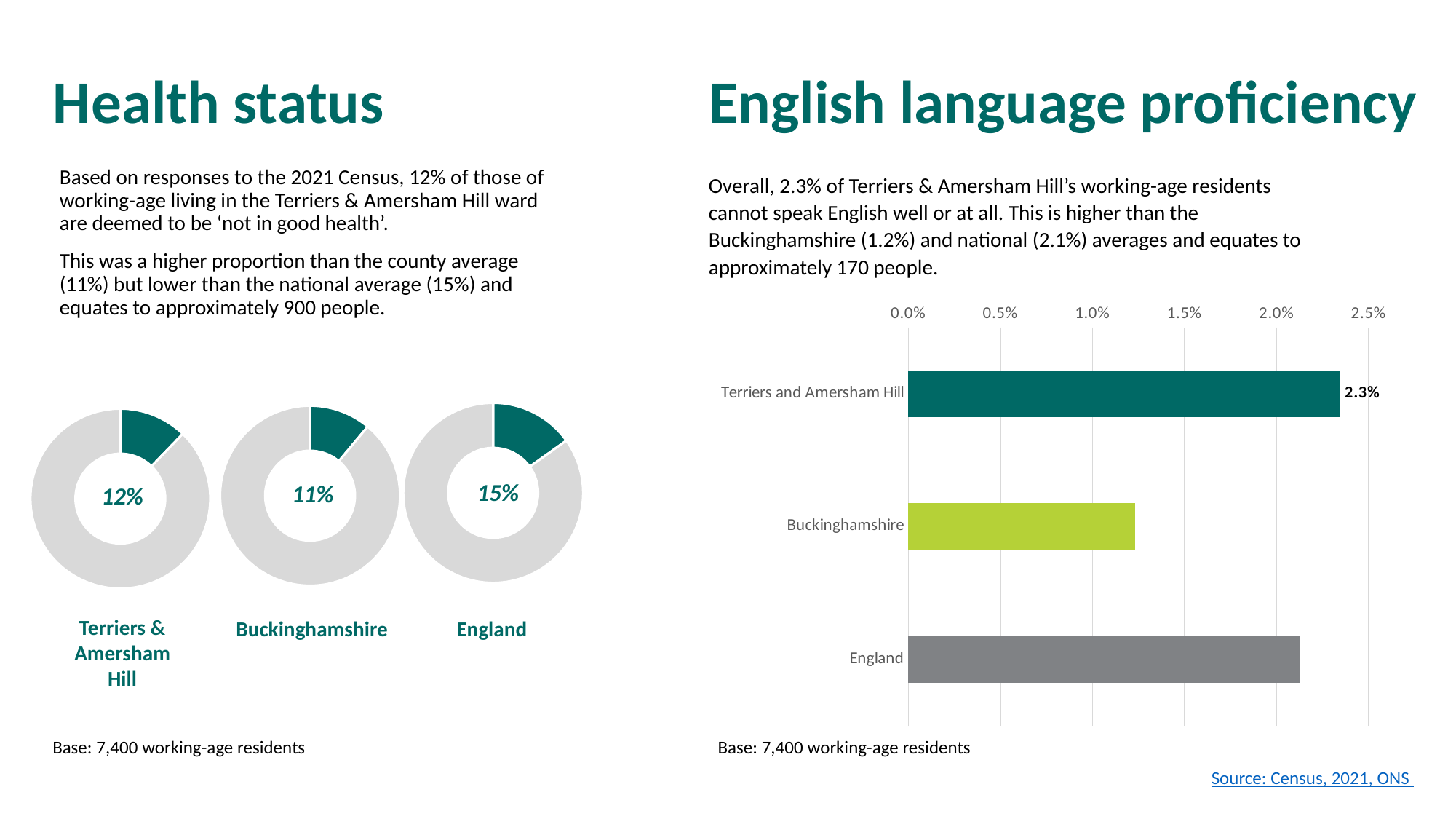
In the English language proficiency chart, is the value for Buckinghamshire greater or less than 1.5%? less In the English language proficiency chart, which area has the longest bar? Terriers and Amersham Hill In the Health status donut charts, what percentage is shown for Terriers & Amersham Hill? 12% In the Health status donut charts, what percentage is shown for England? 15% In the Health status donut charts, what percentage is shown for Buckinghamshire? 11% What kind of chart is the English language proficiency chart? bar chart In the Health status donut charts, what is the difference between the England value and the Terriers & Amersham Hill value? 3% How many donut charts are shown under Health status? 3 In the Health status donut charts, which area has the highest percentage? England In the Health status donut charts, which area has the lowest percentage? Buckinghamshire In the English language proficiency chart, what value is labelled for Terriers and Amersham Hill? 2.3% In the English language proficiency chart, which area has the shortest bar? Buckinghamshire